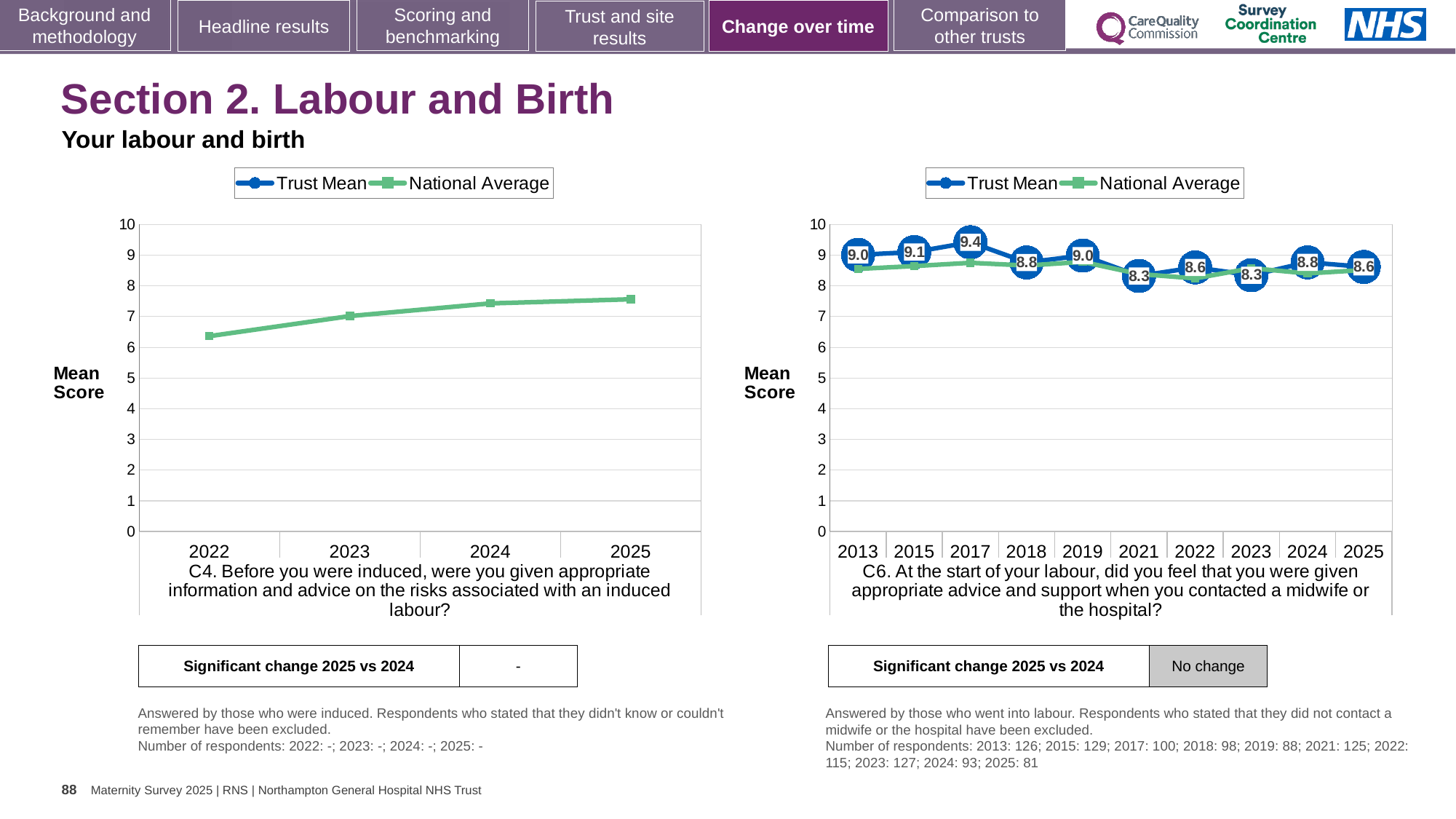
In the C6 chart on the right, what are the two legend entries? Trust Mean and National Average In the C4 chart on the left, how many series does the legend list? 2 In the C6 chart on the right, what is the Trust Mean score for 2017? 9.4 In the C6 chart on the right, what is the difference between the Trust Mean scores for 2017 and 2025? 0.8 In the C6 chart on the right, how many years are plotted on the x axis? 10 In the C6 chart on the right, which year has the highest Trust Mean score? 2017 In the C4 chart on the left, does the National Average line rise or fall from 2022 to 2025? Rise In the C6 chart on the right, what is the Trust Mean score for 2025? 8.6 In the C6 chart on the right, which year has the larger Trust Mean score, 2024 or 2025? 2024 In the C4 chart on the left, is the National Average value for 2022 greater or less than 7? less In the C6 chart on the right, what is the Trust Mean score for 2013? 9.0 What type of chart is the C6 chart on the right? Line chart